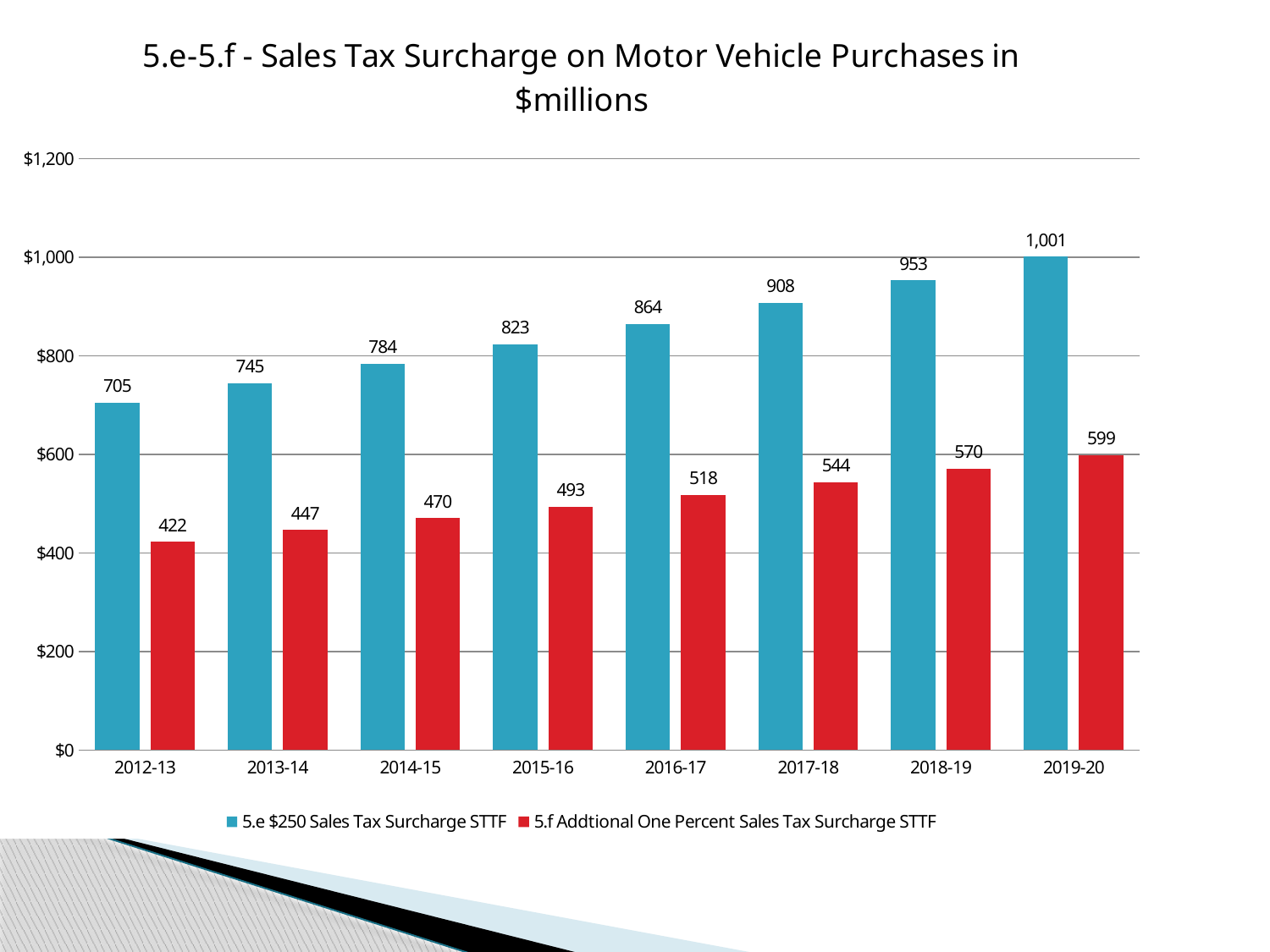
What is the difference between the 5.e $250 Sales Tax Surcharge STTF value and the 5.f Addtional One Percent Sales Tax Surcharge STTF value in 2019-20? 402 Do the values for the 5.f Addtional One Percent Sales Tax Surcharge STTF series rise or fall from 2012-13 to 2019-20? rise Which year has the lowest value for the 5.f Addtional One Percent Sales Tax Surcharge STTF series? 2012-13 What is the value for the 5.e $250 Sales Tax Surcharge STTF series in 2015-16? 823 Which is larger: the 5.e $250 Sales Tax Surcharge STTF value in 2012-13 or the 5.f Addtional One Percent Sales Tax Surcharge STTF value in 2019-20? 5.e $250 Sales Tax Surcharge STTF value in 2012-13 How many fiscal years are shown on the x axis? 8 Which year has the highest value for the 5.e $250 Sales Tax Surcharge STTF series? 2019-20 What colour are the bars for the 5.f Addtional One Percent Sales Tax Surcharge STTF series? red Is the value for the 5.e $250 Sales Tax Surcharge STTF series in 2017-18 greater or less than $800? greater How many series does the legend list? 2 What is the value for the 5.f Addtional One Percent Sales Tax Surcharge STTF series in 2017-18? 544 What kind of chart is shown on the slide? bar chart